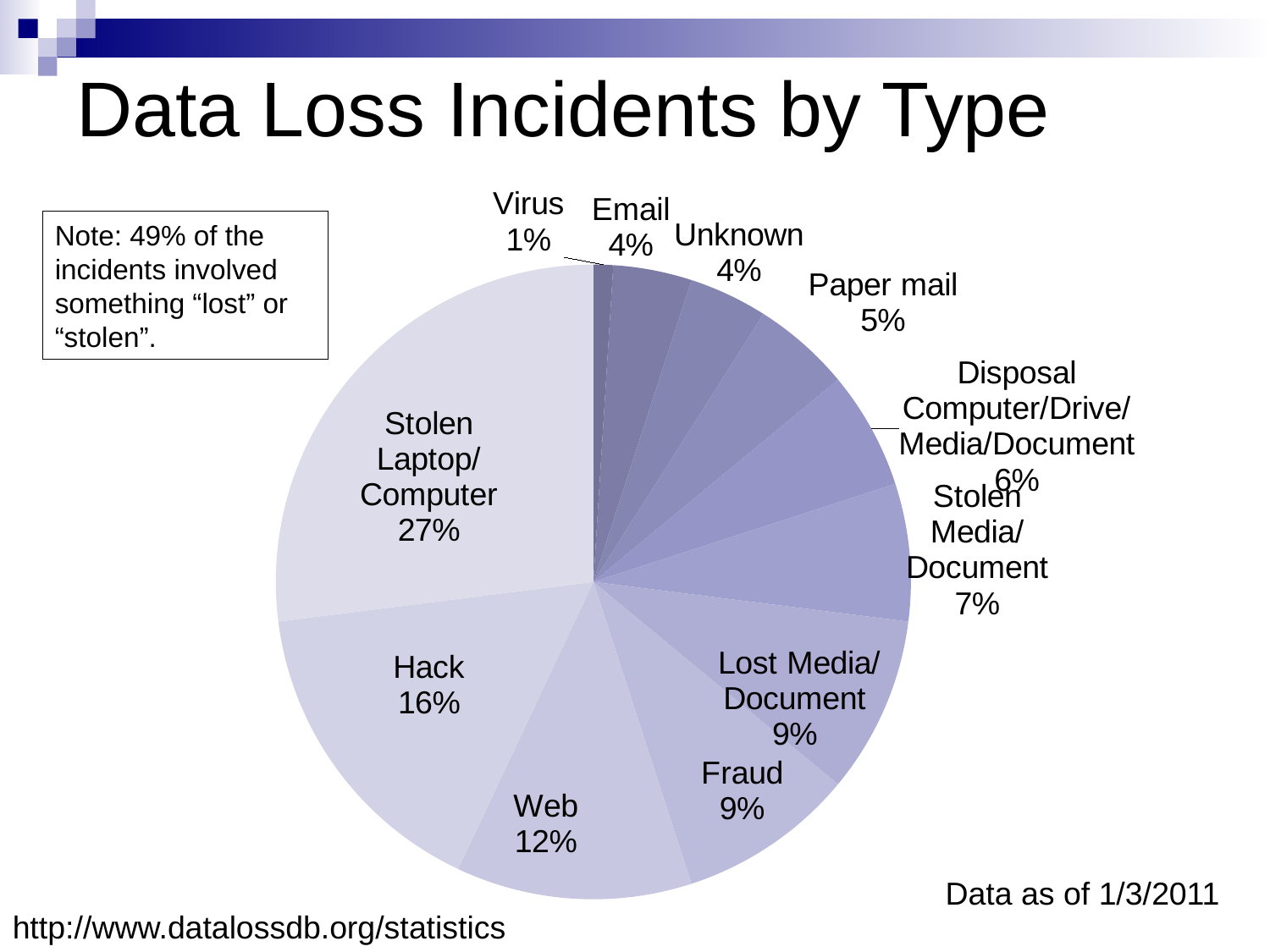
What percentage of incidents is attributed to Web? 12% What is the combined share of Lost Media/Document and Fraud? 18% What percentage of incidents is attributed to Hack? 16% What kind of chart is shown on the slide? pie chart What is the title of the chart on the slide? Data Loss Incidents by Type How many percentage points larger is the Stolen Laptop/Computer share than the Hack share? 11 What share of data loss incidents is attributed to Stolen Laptop/Computer? 27% Which incident type has the smallest share of the pie? Virus Which has a larger share, Web or Fraud? Web What percentage of incidents is attributed to Paper mail? 5% How many slices does the pie chart have? 11 Which incident type has the largest share of the pie? Stolen Laptop/Computer